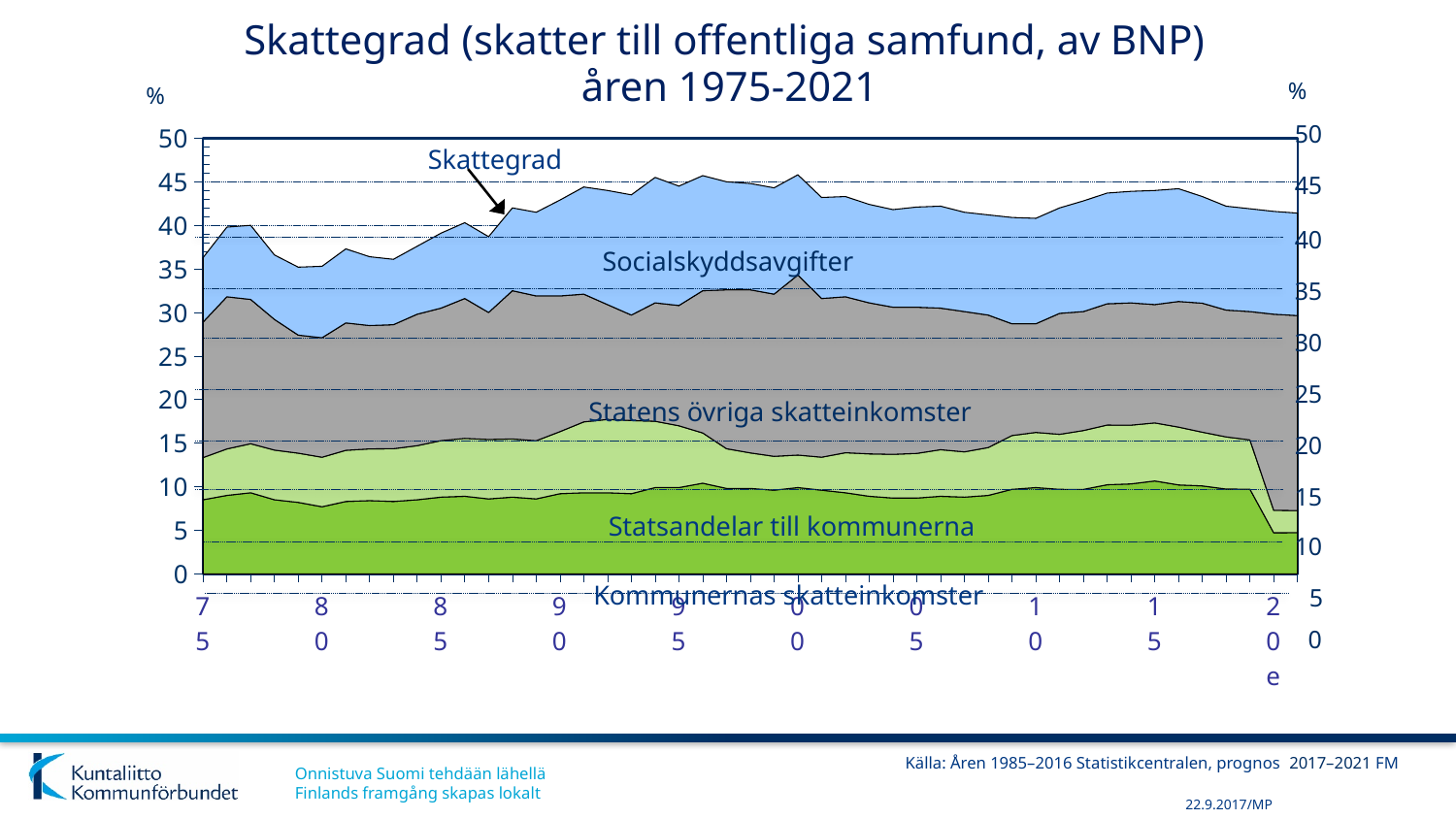
Does the Skattegrad (top line) rise or fall between 2015 and 2021? fall Is the Skattegrad (top line) in 1975 greater or less than 30? greater Is the Skattegrad (top line) in 1980 greater or less than 40? less What kind of chart is shown on the slide? Stacked area chart Which is larger, the Skattegrad in 1980 or the Skattegrad in 2000? 2000 What is the title of the chart? Skattegrad (skatter till offentliga samfund, av BNP) åren 1975-2021 Is the Skattegrad (top line) in 2021 greater or less than 35? greater Which series is plotted at the bottom of the stacked areas? Kommunernas skatteinkomster Does the Skattegrad (top line) rise or fall between 1975 and 1990? rise How many stacked series (areas) are shown in the chart? 4